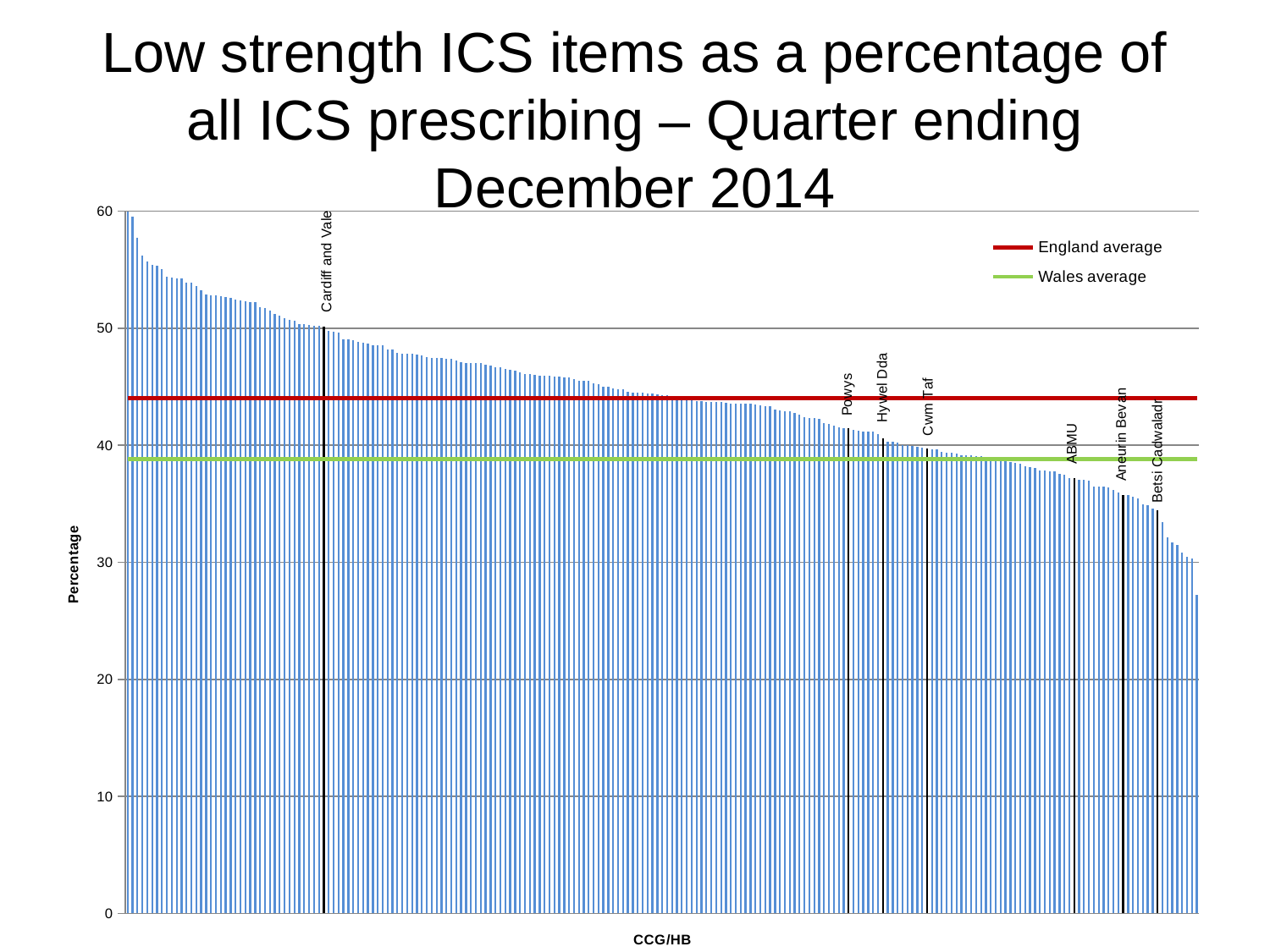
Is the value for Cardiff and Vale greater or less than 40? greater Which has the higher value, Cardiff and Vale or Betsi Cadwaladr? Cardiff and Vale Of the labelled Welsh health boards, which has the highest value? Cardiff and Vale Which has the higher value, Powys or Aneurin Bevan? Powys How many entries does the chart legend list? 2 Is the value for Powys greater or less than 50? less Is the value for Aneurin Bevan greater or less than 40? less Of the labelled Welsh health boards, which has the lowest value? Betsi Cadwaladr What kind of chart is shown on the slide? bar chart Do the bar values rise or fall from left to right along the x axis? fall What colour is the line representing the England average? red